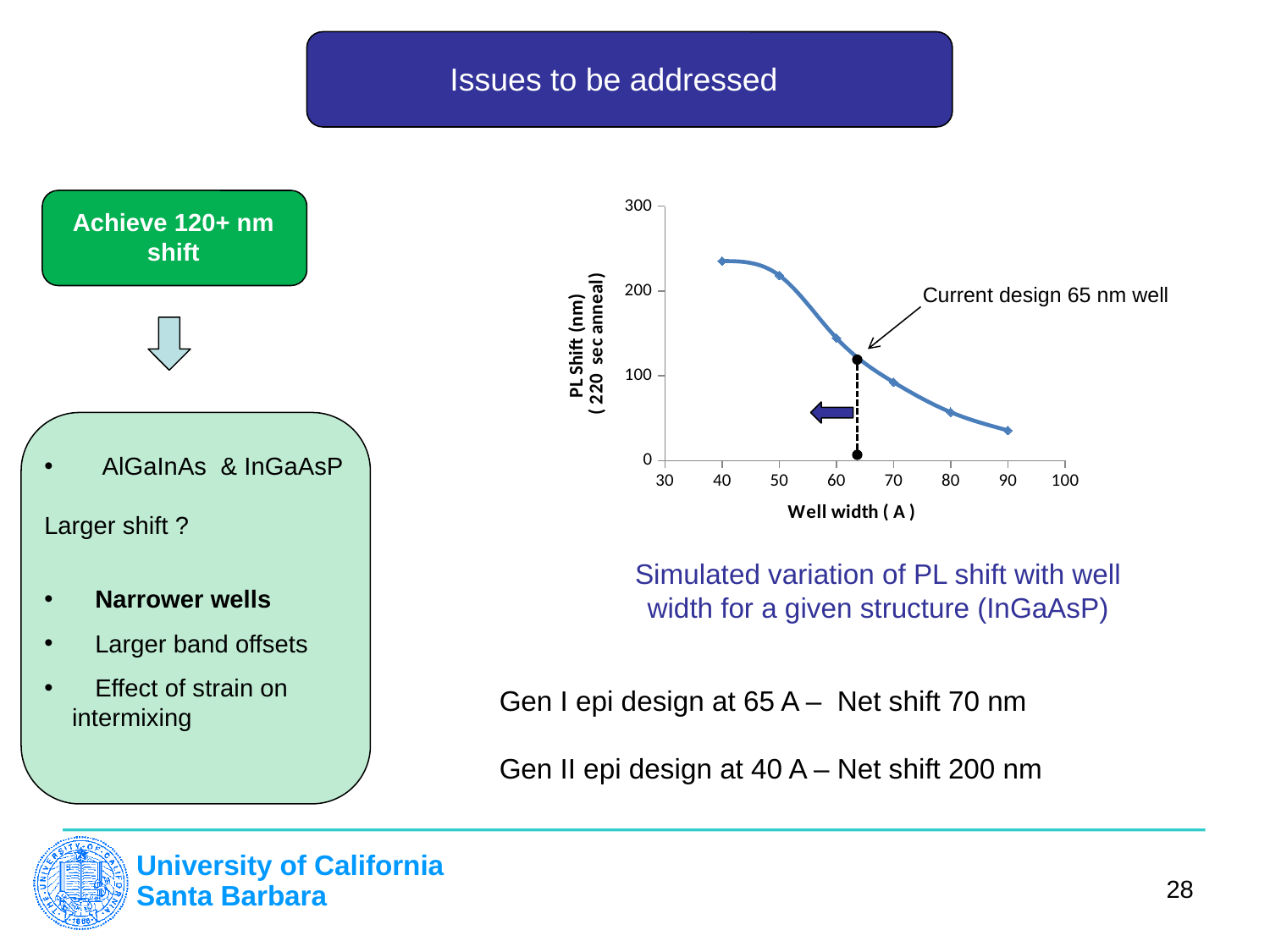
Is the PL shift at a well width of 60 A greater or less than 100? greater Is the PL shift at a well width of 80 A greater or less than 100? less Which has a larger PL shift: a well width of 60 A or 80 A? 60 A What kind of chart is shown on the slide? line chart As well width increases along the x axis, does the PL shift rise or fall? fall Is the PL shift at a well width of 40 A greater or less than 200? greater At which well width is the plotted PL shift highest? 40 At which well width is the plotted PL shift lowest? 90 What well width does the annotation on the chart identify as the current design? 65 nm well How many data points are plotted on the PL shift curve? 6 What is the label of the x axis of the chart? Well width ( A )